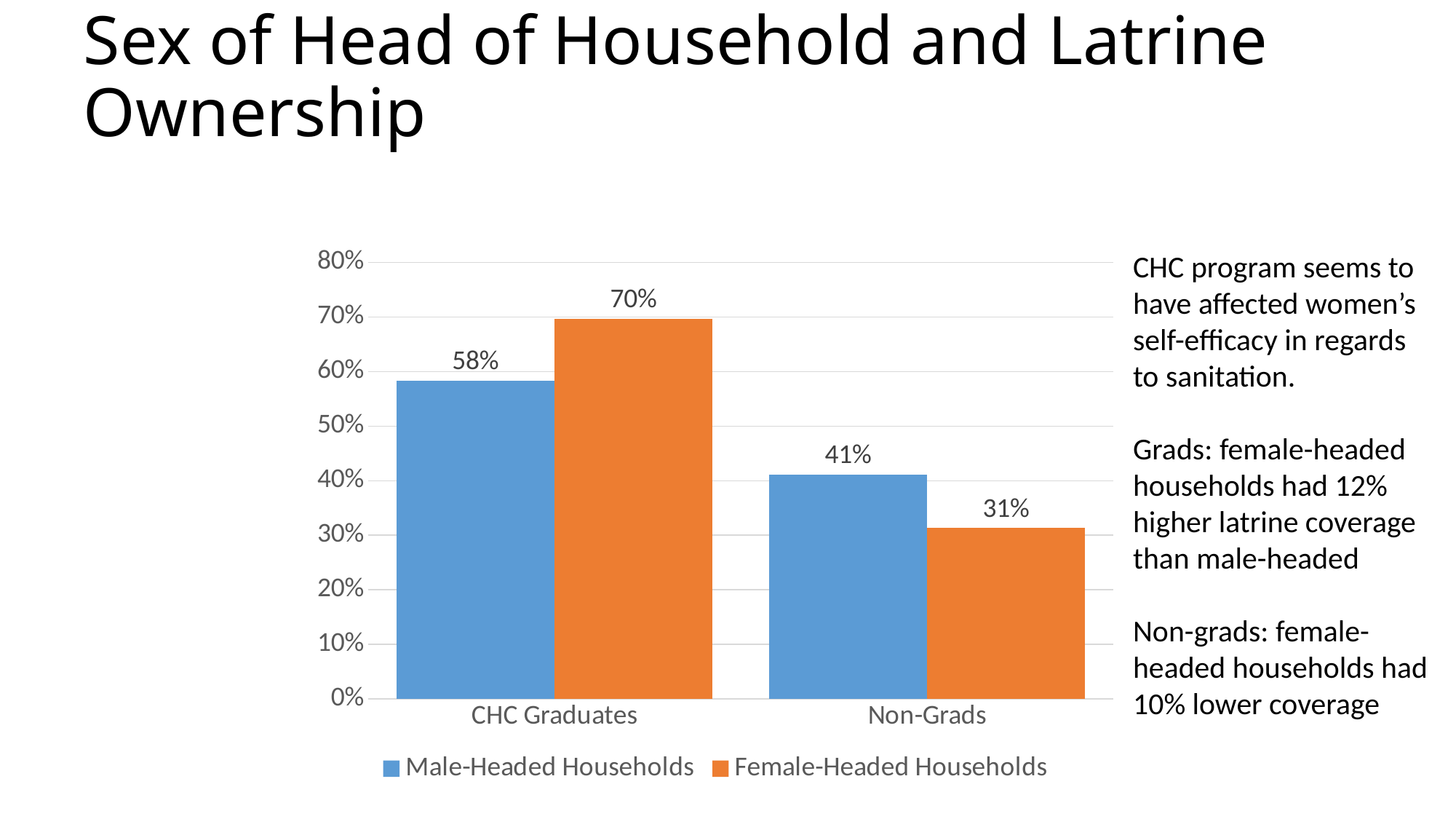
How many categories are shown on the x axis? 2 Which bar has the lowest value on the chart? Female-Headed Households, Non-Grads What is the difference between Male-Headed and Female-Headed Households among Non-Grads? 10% What is the latrine ownership value for Female-Headed Households among CHC Graduates? 70% What is the difference between Female-Headed and Male-Headed Households among CHC Graduates? 12% What kind of chart is shown on the slide? Bar chart Which bar has the highest value on the chart? Female-Headed Households, CHC Graduates What is the latrine ownership value for Male-Headed Households among CHC Graduates? 58% Among Non-Grads, which is larger: Male-Headed Households or Female-Headed Households? Male-Headed Households What is the value for Female-Headed Households among Non-Grads? 31% How many series does the legend list? 2 What is the value for Male-Headed Households among Non-Grads? 41%